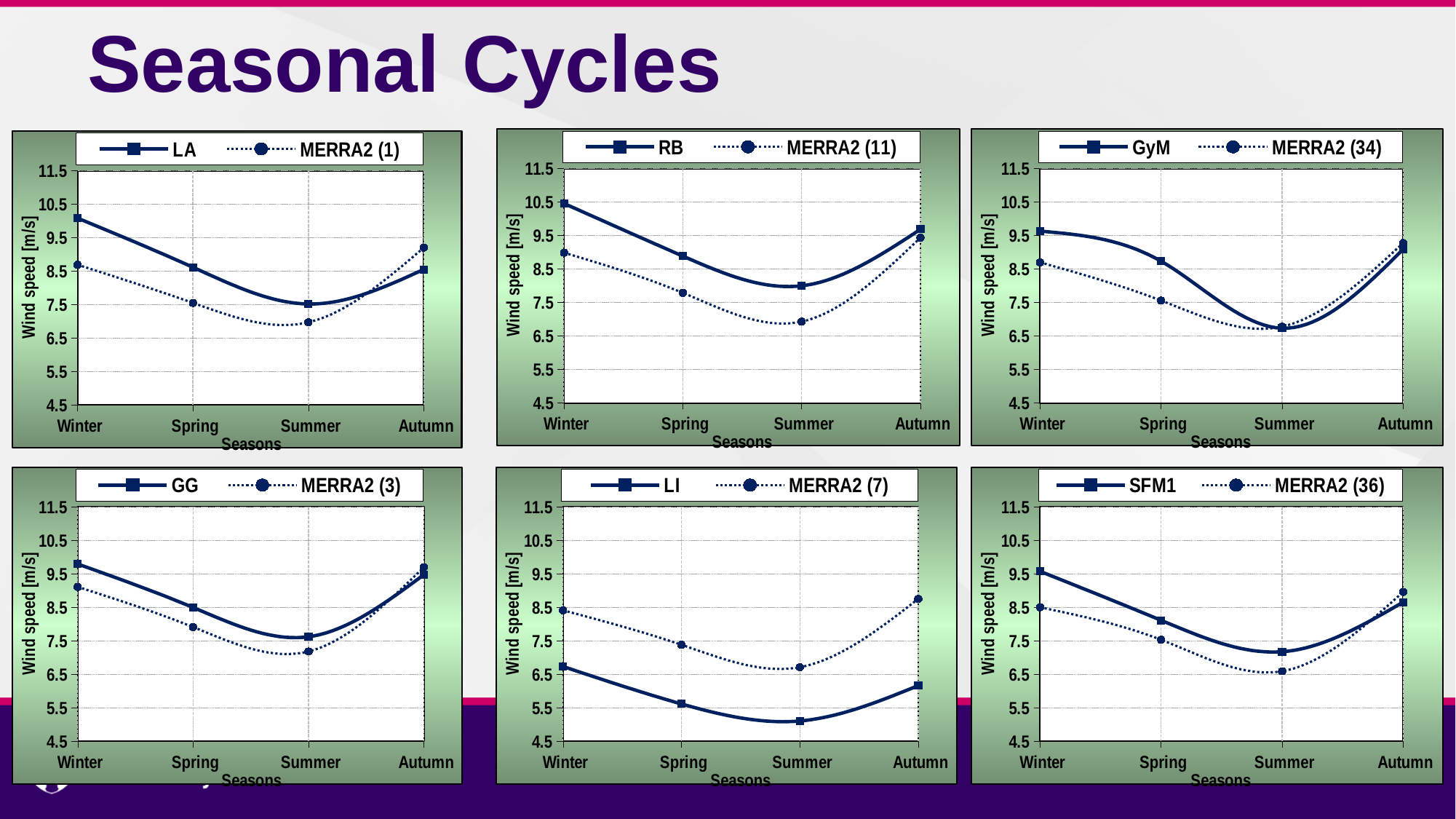
In the bottom-right chart, does the SFM1 wind speed rise or fall from Winter to Summer? fall In the bottom-left chart, is the GG value for Winter greater or less than 9.5? greater In the top-middle chart, is the RB value for Summer greater or less than 7.5? greater What is the y-axis label on the top-right chart (GyM)? Wind speed [m/s] In the bottom-middle chart, is the LI value for Summer greater or less than 5.5? less What kind of chart is the top-left chart with the LA legend? line chart How many series does the legend of the bottom-middle chart (LI) list? 2 In the bottom-middle chart, which series is higher in Summer, LI or MERRA2 (7)? MERRA2 (7) In the top-middle chart, which season has the highest RB wind speed? Winter In the top-left chart, which season has the lowest LA wind speed? Summer How many seasons are plotted on the x axis of the top-left chart (LA)? 4